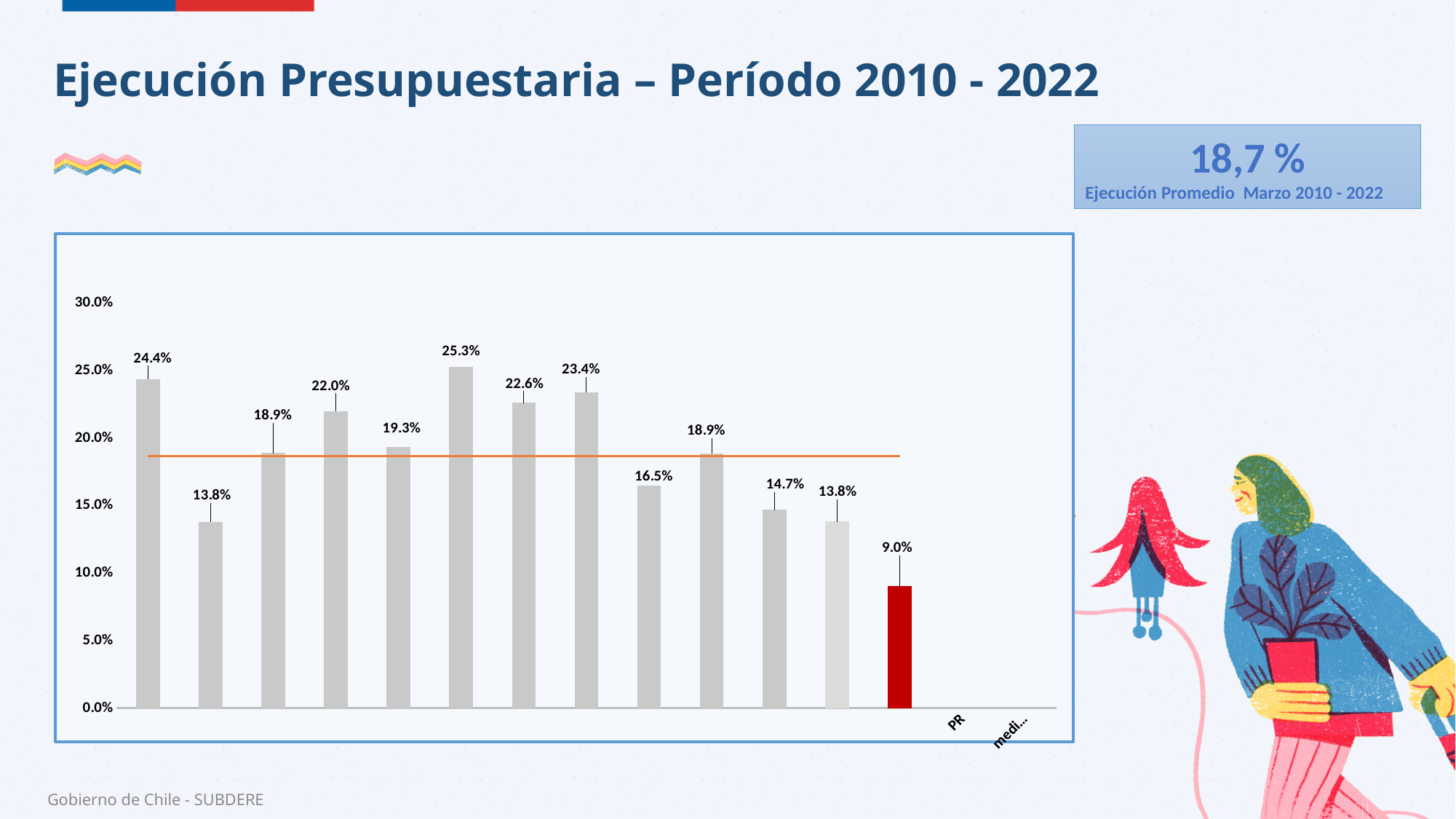
What is the difference between the highest bar (25.3%) and the lowest bar (9.0%)? 16.3 percentage points What is the highest value shown in the chart? 25.3% What average execution value is shown in the box above the chart? 18,7 % How many bars are plotted in the chart? 13 What is the value of the first bar from the left in the chart? 24.4% What kind of chart is shown on the slide? bar chart What is the value of the red bar in the chart? 9.0% Which is larger, the first bar from the left (24.4%) or the red bar (9.0%)? the first bar from the left (24.4%) What colour is the lowest bar in the chart? red Do the values rise or fall across the last four bars of the chart? fall What is the lowest value shown in the chart? 9.0% Is the value of the red bar greater or less than 10.0%? less